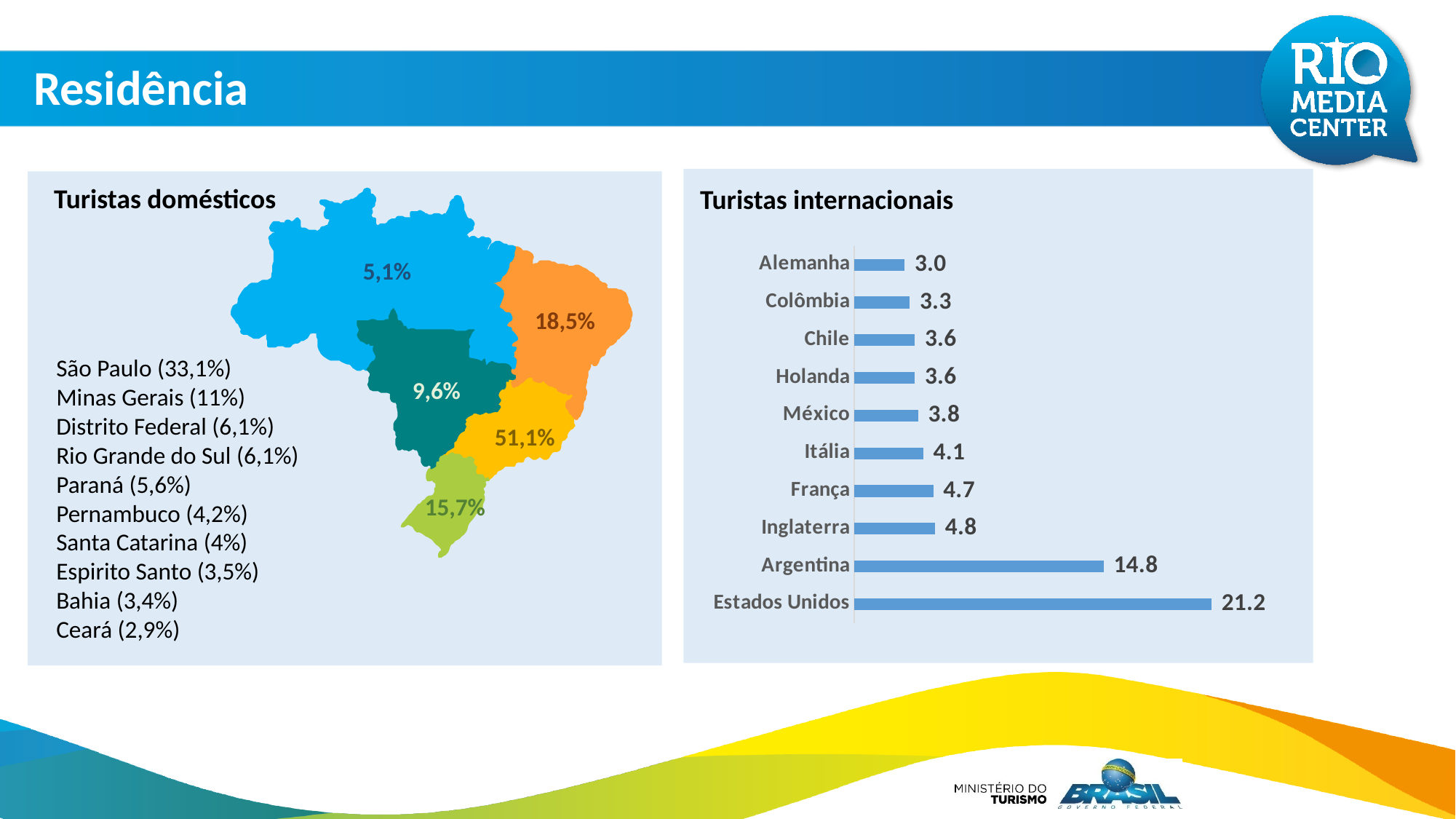
In the 'Turistas internacionais' chart, which country has the highest value? Estados Unidos In the 'Turistas domésticos' map, what percentage is shown on the yellow region? 51,1% In the 'Turistas internacionais' chart, what is the value for Argentina? 14.8 In the 'Turistas internacionais' chart, which country has the lowest value? Alemanha In the 'Turistas domésticos' map, which region has the lowest percentage shown? The light blue region (5,1%) In the 'Turistas internacionais' chart, what is the value for Itália? 4.1 In the 'Turistas internacionais' chart, what is the value for Alemanha? 3.0 In the 'Turistas internacionais' chart, what is the difference between the values for Estados Unidos and Argentina? 6.4 How many countries are shown in the 'Turistas internacionais' chart? 10 In the 'Turistas internacionais' chart, which is larger, the value for México or the value for Colômbia? México What kind of chart is the 'Turistas internacionais' chart? Bar chart In the 'Turistas internacionais' chart, what is the difference between the values for Inglaterra and França? 0.1